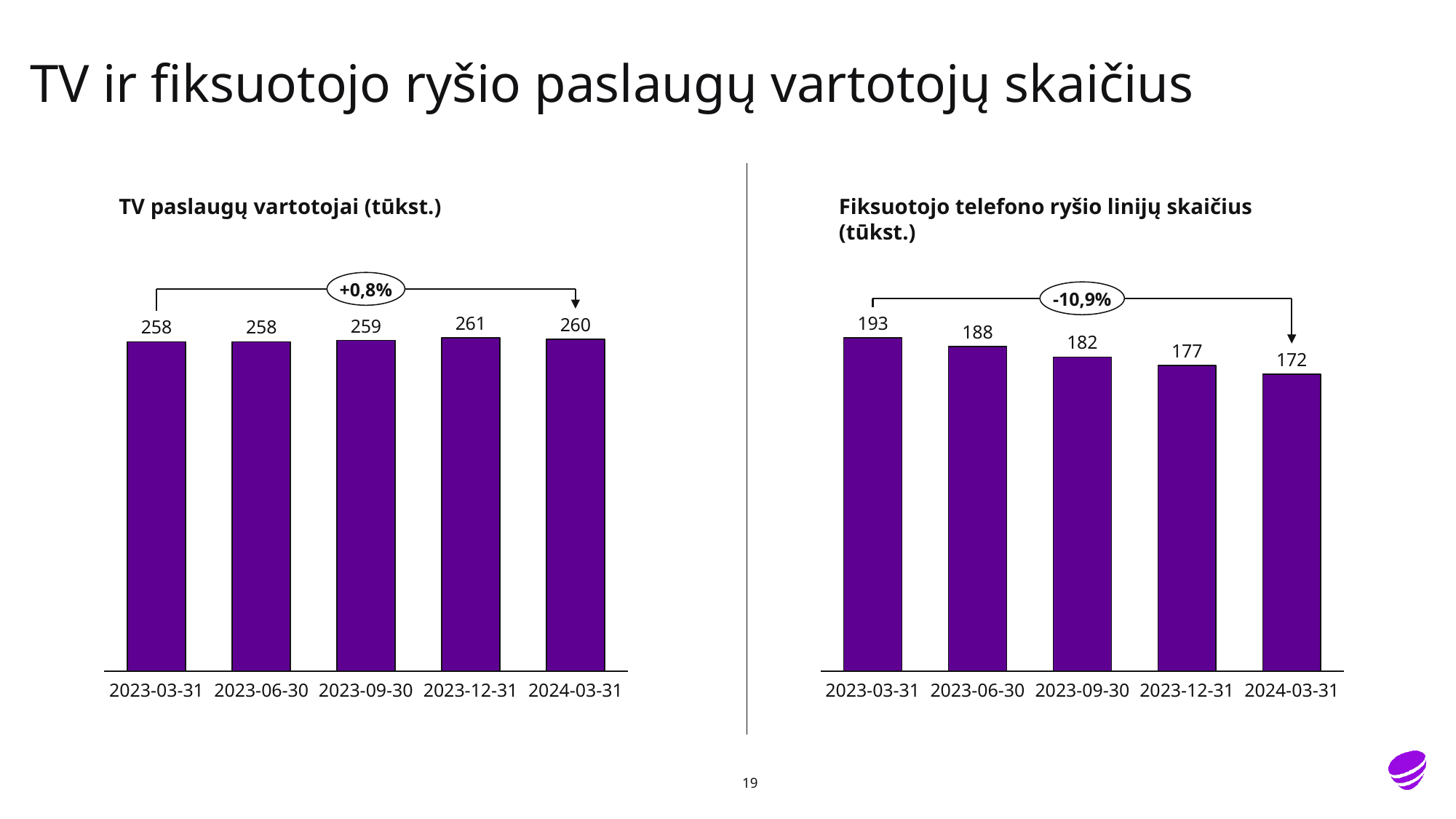
In the 'Fiksuotojo telefono ryšio linijų skaičius (tūkst.)' chart, what is the difference between the values for 2023-03-31 and 2024-03-31? 21 In the 'Fiksuotojo telefono ryšio linijų skaičius (tūkst.)' chart, which date has the lowest value? 2024-03-31 In the 'TV paslaugų vartotojai (tūkst.)' chart, which date has the highest value? 2023-12-31 In the 'TV paslaugų vartotojai (tūkst.)' chart, what is the value for 2024-03-31? 260 In the 'Fiksuotojo telefono ryšio linijų skaičius (tūkst.)' chart, which date has the highest value? 2023-03-31 How many bars are in the 'TV paslaugų vartotojai (tūkst.)' chart? 5 In the 'Fiksuotojo telefono ryšio linijų skaičius (tūkst.)' chart, do the values rise or fall from 2023-03-31 to 2024-03-31? fall What percentage change is shown in the annotation above the 'Fiksuotojo telefono ryšio linijų skaičius (tūkst.)' chart? -10,9% What kind of chart is the 'Fiksuotojo telefono ryšio linijų skaičius (tūkst.)' chart? bar chart In the 'TV paslaugų vartotojai (tūkst.)' chart, what is the value for 2023-12-31? 261 In the 'Fiksuotojo telefono ryšio linijų skaičius (tūkst.)' chart, what is the value for 2023-09-30? 182 In the 'TV paslaugų vartotojai (tūkst.)' chart, what is the difference between the values for 2023-12-31 and 2023-03-31? 3